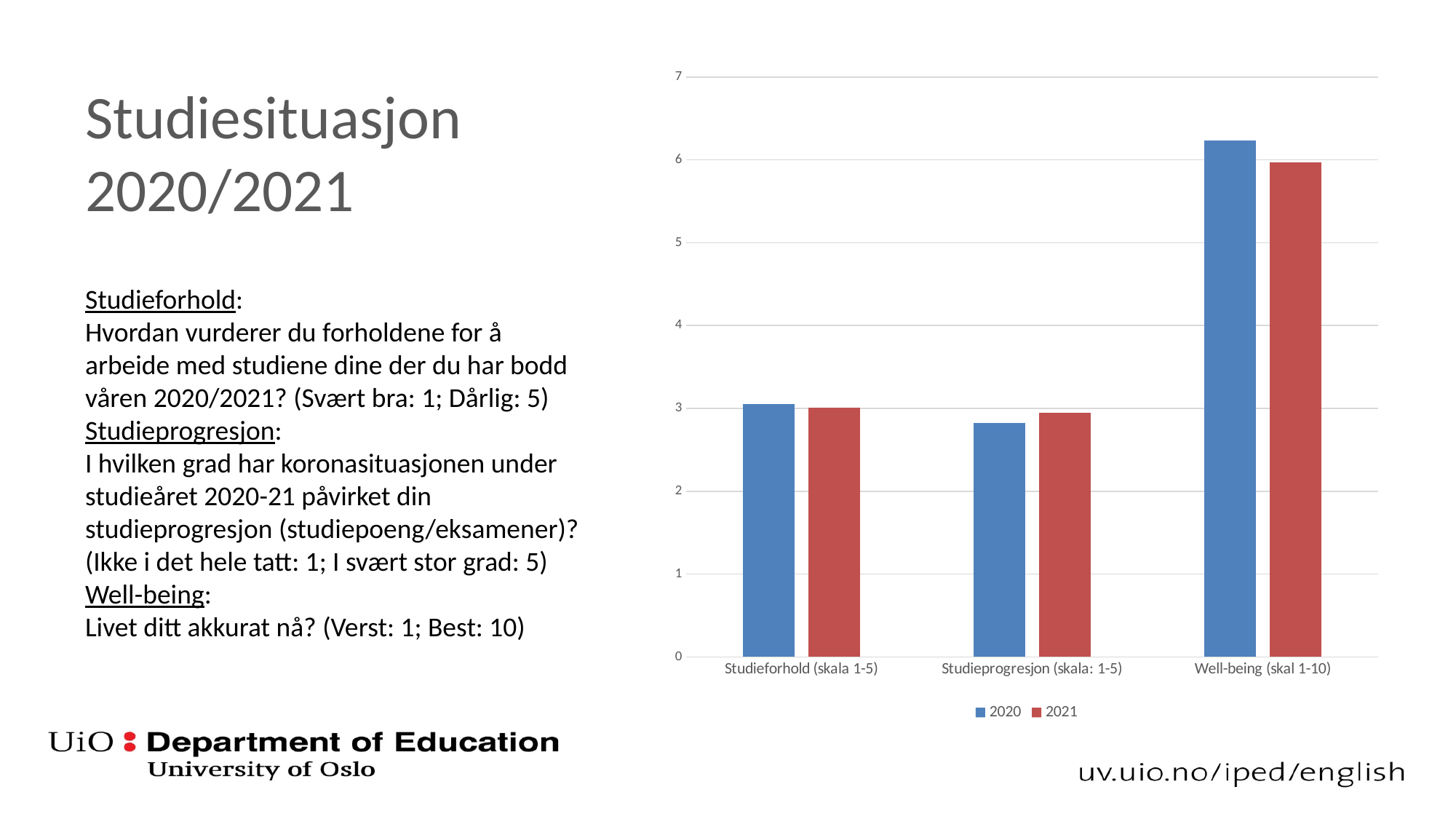
Is the 2021 value for Studieforhold (skala 1-5) greater or less than 2? greater How many categories are shown on the x axis of the chart? 3 Is the 2020 value for Well-being (skal 1-10) greater or less than 6? greater Which series are listed in the chart legend? 2020 and 2021 What colour are the bars for the 2021 series? red Is the 2020 value for Studieprogresjon (skala: 1-5) greater or less than 3? less Which category has the lowest bar for the 2020 series? Studieprogresjon (skala: 1-5) For Studieprogresjon (skala: 1-5), which year has the larger value, 2020 or 2021? 2021 For Well-being (skal 1-10), which year has the larger value, 2020 or 2021? 2020 How many series does the chart legend list? 2 What kind of chart is shown on the slide? bar chart Which category has the highest bar in the chart? Well-being (skal 1-10)